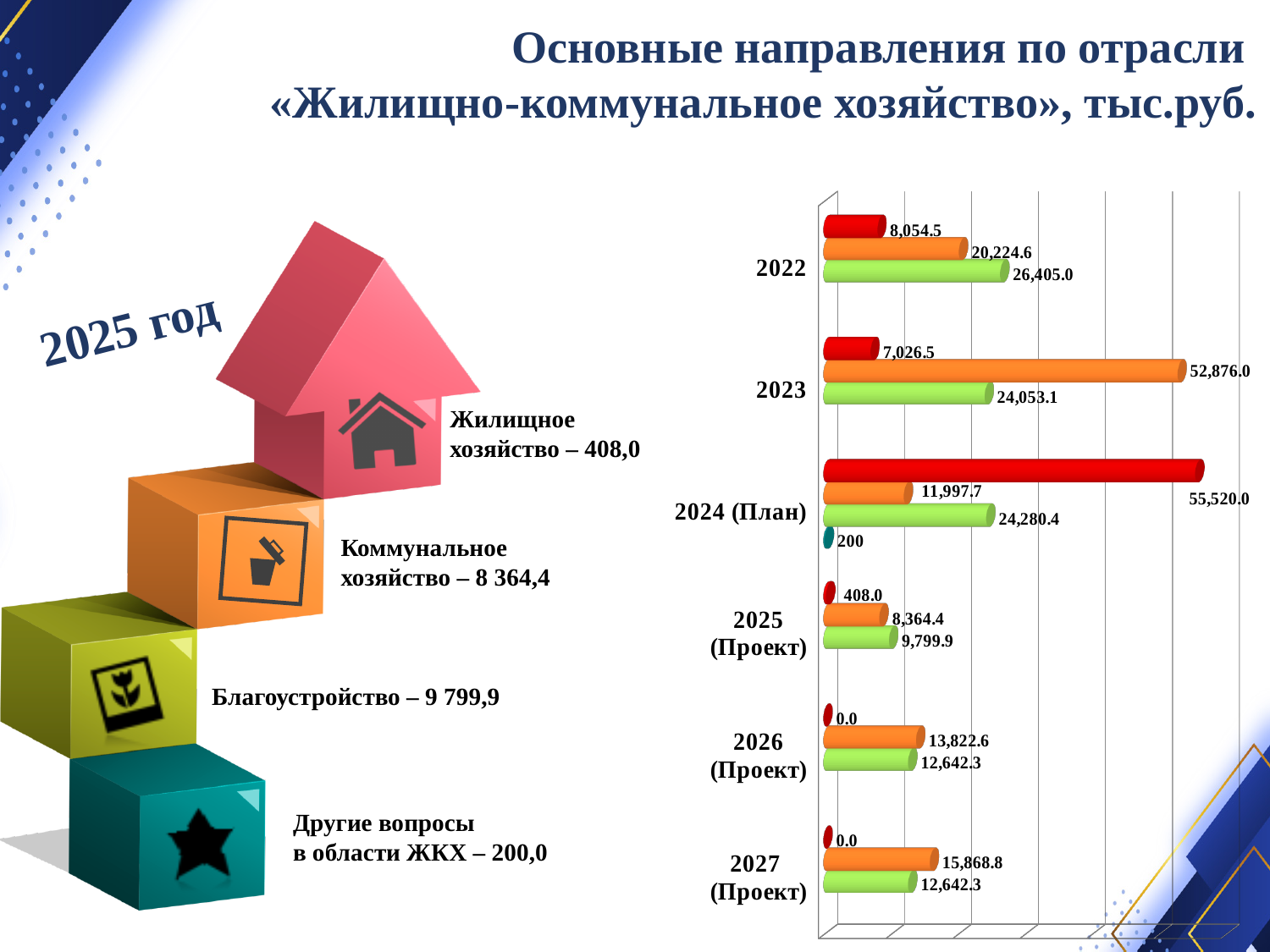
What is the value of the red bar for 2022? 8,054.5 For 2022, which is larger: the green bar or the orange bar? the green bar What is the title of the slide containing the chart? Основные направления по отрасли «Жилищно-коммунальное хозяйство», тыс.руб. What is the value of the orange bar for 2027 (Проект)? 15,868.8 In which year category is the orange bar the lowest? 2025 (Проект) What is the difference between the orange bar and the green bar for 2023? 28,822.9 How many year categories are shown on the chart? 6 In which year category is the red bar the highest? 2024 (План) What is the value of the green bar for 2024 (План)? 24,280.4 Does the orange bar rise or fall from 2025 (Проект) to 2027 (Проект)? rise What is the value of the orange bar for 2023? 52,876.0 What type of chart is shown on the slide? bar chart